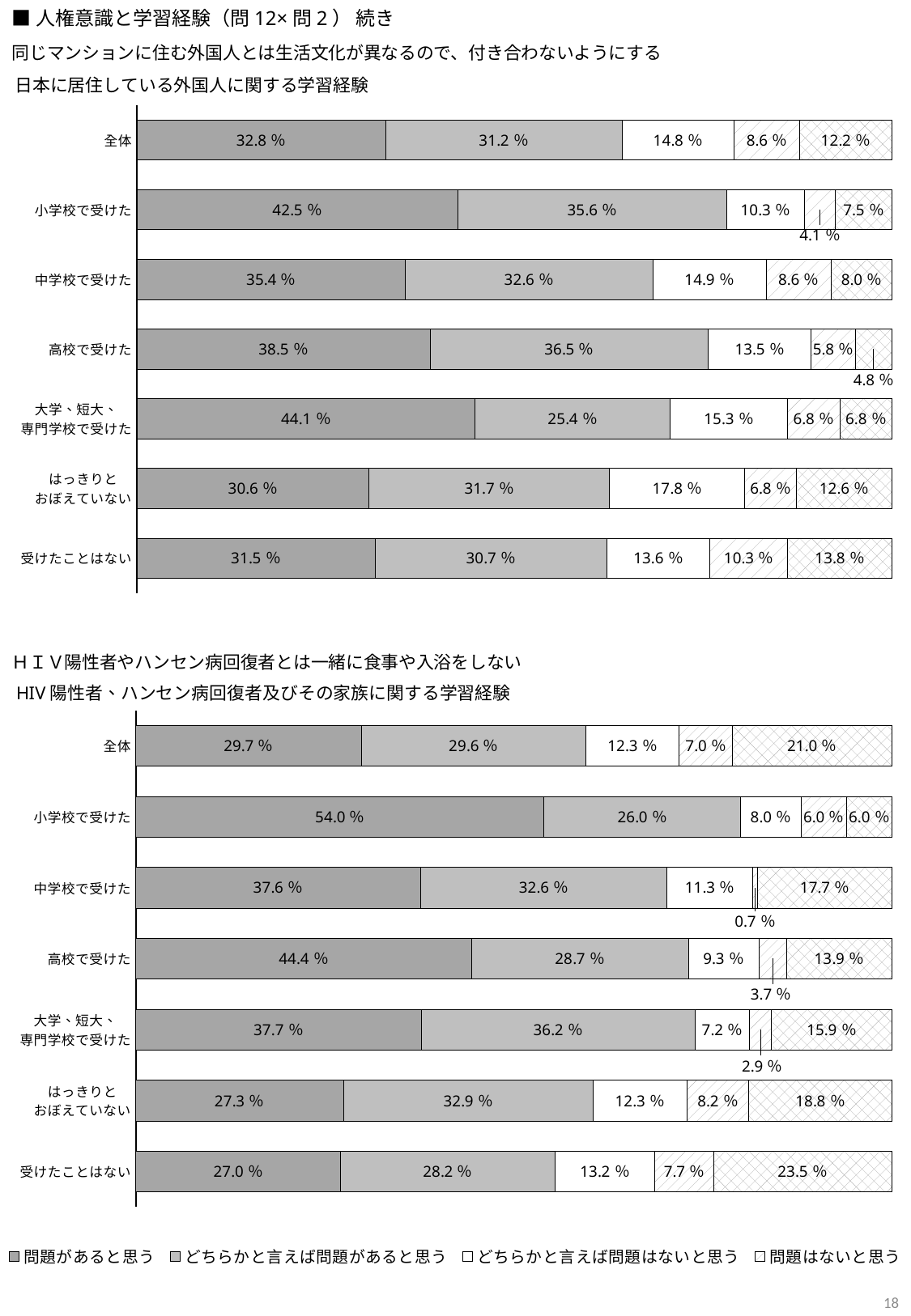
What kind of chart is the chart titled HIV 陽性者、ハンセン病回復者及びその家族に関する学習経験? Stacked horizontal bar chart In the chart titled 日本に居住している外国人に関する学習経験, what is the value of 問題があると思う for 全体? 32.8 % In the chart titled HIV 陽性者、ハンセン病回復者及びその家族に関する学習経験, what is the difference in 問題があると思う between 小学校で受けた and 受けたことはない? 27.0 % In the chart titled 日本に居住している外国人に関する学習経験, what is the value of どちらかと言えば問題があると思う for 小学校で受けた? 35.6 % In the chart titled HIV 陽性者、ハンセン病回復者及びその家族に関する学習経験, what is the value of the rightmost segment for 受けたことはない? 23.5 % In the chart titled 日本に居住している外国人に関する学習経験, which category has the highest value for 問題があると思う? 大学、短大、専門学校で受けた In the chart titled HIV 陽性者、ハンセン病回復者及びその家族に関する学習経験, what is the value of 問題はないと思う for 中学校で受けた? 0.7 % In the chart titled 日本に居住している外国人に関する学習経験, which is larger for 問題があると思う: 高校で受けた or 中学校で受けた? 高校で受けた In the chart titled HIV 陽性者、ハンセン病回復者及びその家族に関する学習経験, what is the value of 問題があると思う for 小学校で受けた? 54.0 % In the chart titled 日本に居住している外国人に関する学習経験, what is the value of どちらかと言えば問題はないと思う for 高校で受けた? 13.5 % How many categories are shown on the vertical axis of the chart titled 日本に居住している外国人に関する学習経験? 7 In the chart titled HIV 陽性者、ハンセン病回復者及びその家族に関する学習経験, which category has the lowest value for 問題があると思う? 受けたことはない